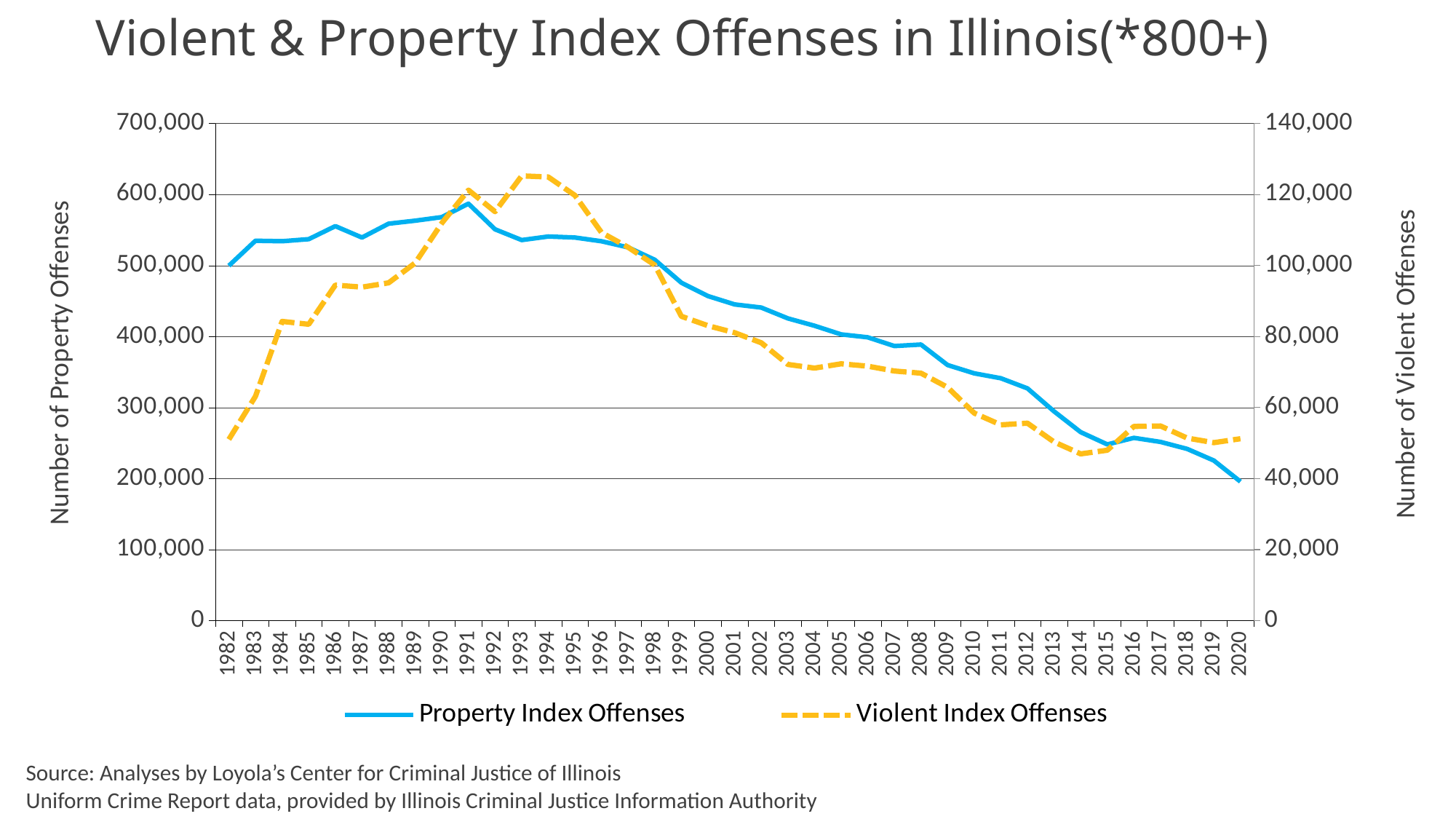
Is the value for Property Index Offenses in 2000 greater or less than 400,000? greater In which year do Property Index Offenses reach their lowest value? 2020 How many years are plotted along the x axis? 39 How many series does the legend list? 2 What is the label on the right-hand vertical axis? Number of Violent Offenses Is the value for Violent Index Offenses in 1982 greater or less than 60,000? less What kind of chart is shown on the slide? Line chart Is the value for Violent Index Offenses in 1999 greater or less than 80,000? greater In which year do Property Index Offenses reach their highest value? 1991 Which is larger for Property Index Offenses: the value in 1991 or the value in 2020? 1991 Do Property Index Offenses rise or fall from 1991 to 2020? Fall